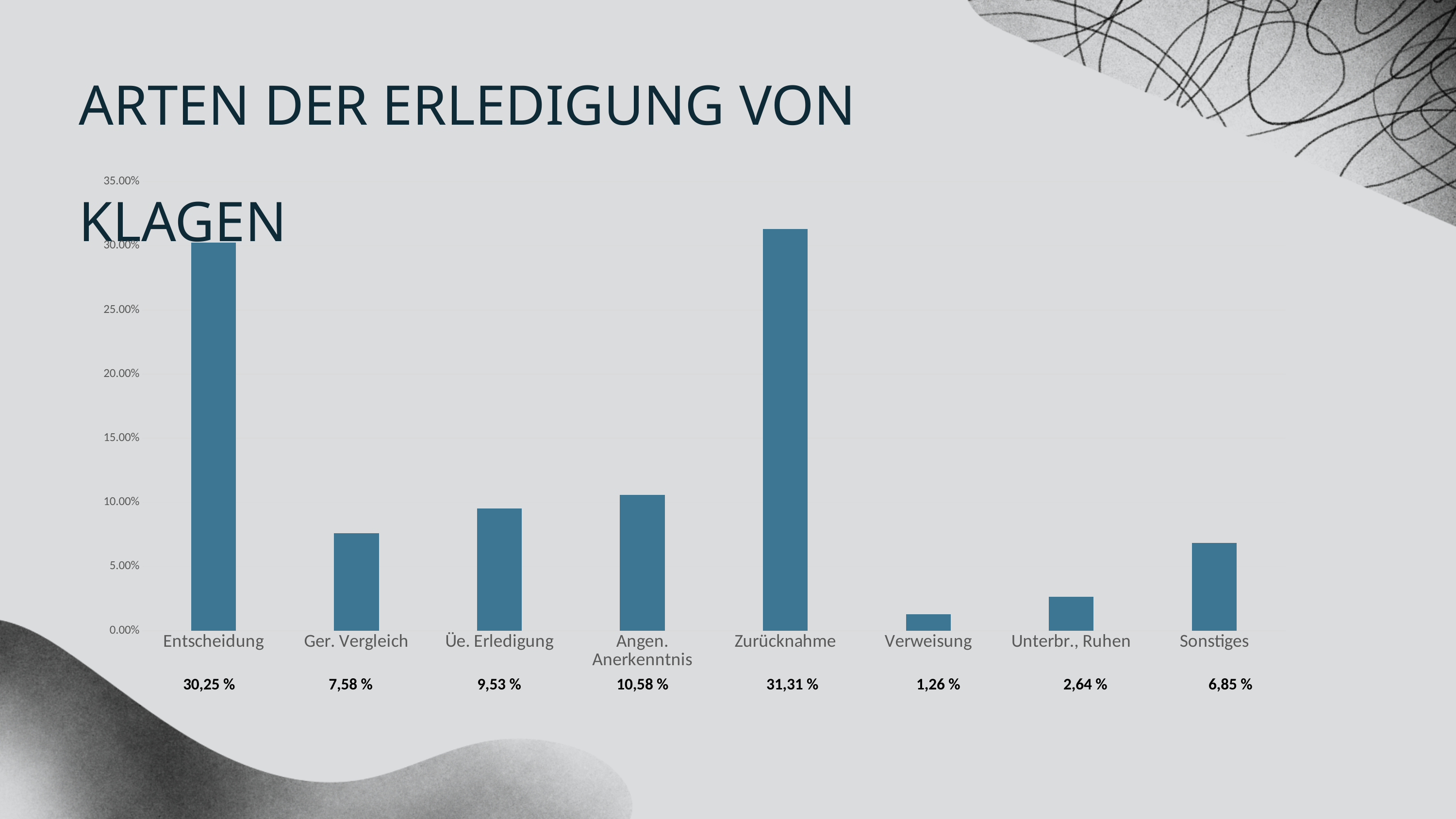
Is the value for Angen. Anerkenntnis greater or less than 10.00%? greater What is the value for Zurücknahme? 31,31 % How many categories are shown on the x axis of the chart? 8 What is the difference between the values for Angen. Anerkenntnis and Ger. Vergleich? 3,00 % What is the value for Sonstiges? 6,85 % Is the value for Unterbr., Ruhen greater or less than 5.00%? less What kind of chart is shown on the slide? bar chart What is the title of the slide containing the chart? ARTEN DER ERLEDIGUNG VON KLAGEN What is the value for Verweisung? 1,26 % Which is larger, the value for Ger. Vergleich or the value for Üe. Erledigung? Üe. Erledigung Which category has the lowest value? Verweisung What is the value for Entscheidung? 30,25 %